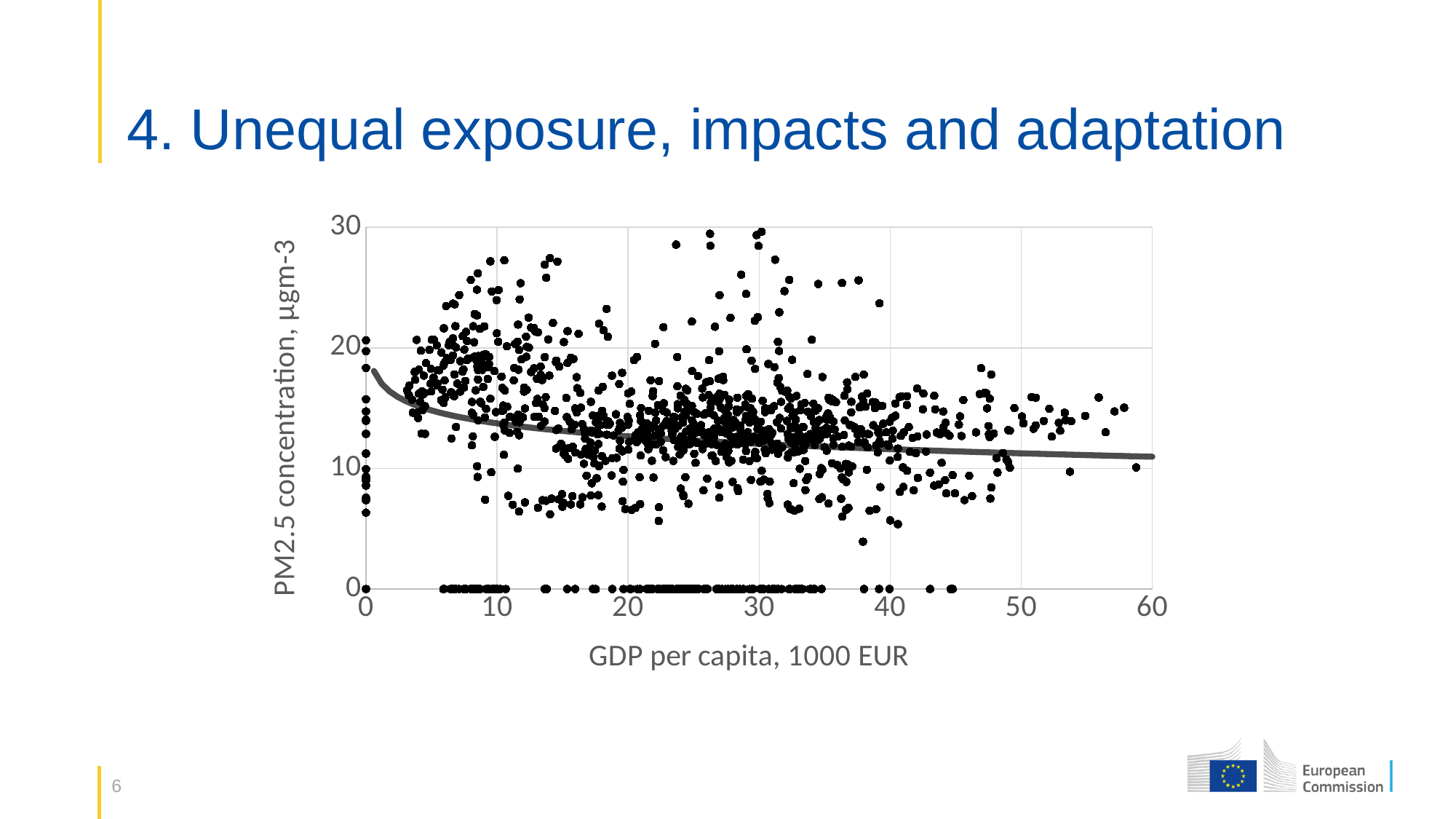
What is the label of the y axis of the chart? PM2.5 concentration, µgm-3 Is the value of the trend line at a GDP per capita of 0 greater or less than 10? greater What is the label of the x axis of the chart? GDP per capita, 1000 EUR Is the trend line higher at a GDP per capita of 10 or at a GDP per capita of 50? 10 What is the highest value shown on the y axis? 30 Does the fitted trend line rise or fall as GDP per capita increases? fall What kind of chart is shown on the slide? scatter plot Is the value of the trend line at a GDP per capita of 60 greater or less than 20? less Is the value of the trend line at a GDP per capita of 50 greater or less than 10? greater What is the highest value shown on the x axis? 60 What is the interval between consecutive tick marks on the x axis? 10